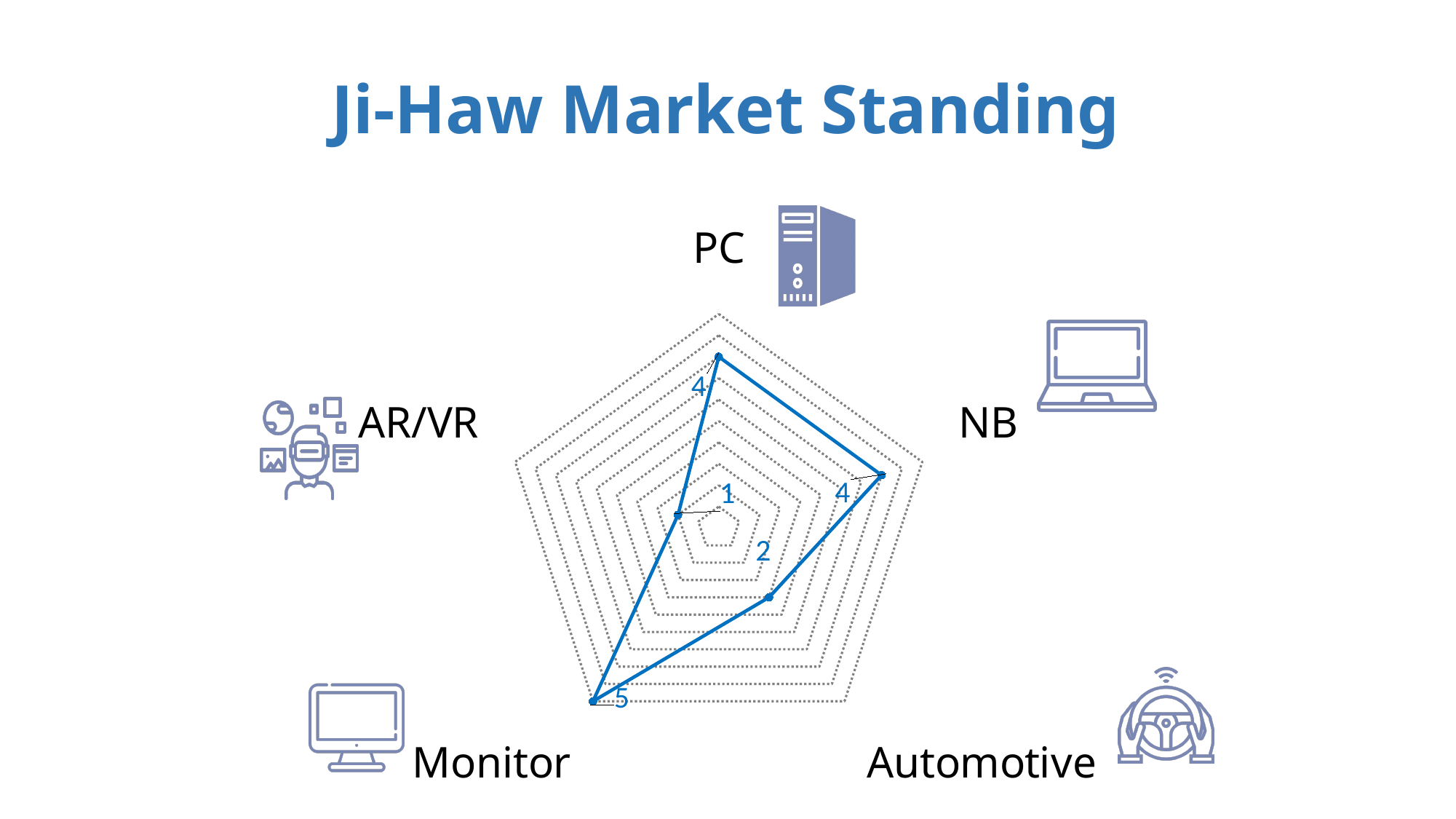
What is the value for Monitor? 5 What is the title of the slide? Ji-Haw Market Standing What is the value for AR/VR? 1 What is the value for Automotive? 2 What is the difference between the values for Monitor and AR/VR? 4 What is the value for NB? 4 Which category has the lowest value? AR/VR What is the value for PC? 4 Which is larger, the value for Automotive or the value for PC? PC What kind of chart is shown on the slide? Radar chart Which category has the highest value? Monitor How many categories does the chart have? 5